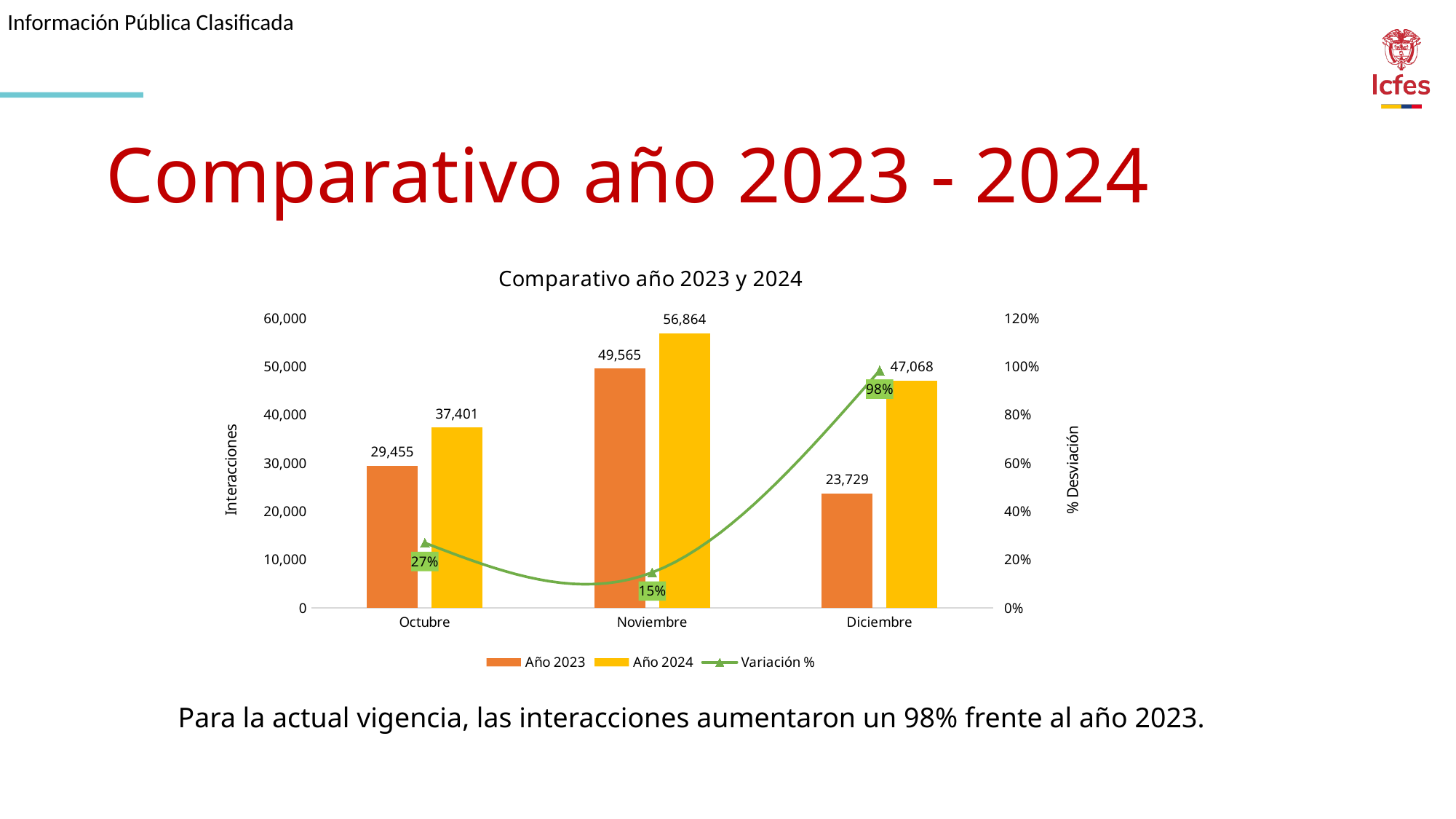
Which is larger in Diciembre, Año 2023 or Año 2024? Año 2024 What kind of chart is this? Combined bar and line chart What is the Variación % value for Octubre? 27% What is the Variación % value for Diciembre? 98% What is the title of the chart? Comparativo año 2023 y 2024 Which month has the lowest value for Año 2024? Octubre How many series does the legend list? 3 How many months are shown on the x axis? 3 Which month has the highest value for Año 2023? Noviembre What is the difference between Año 2024 and Año 2023 in Octubre? 7,946 What is the value for Año 2023 in Diciembre? 23,729 What is the value for Año 2024 in Noviembre? 56,864